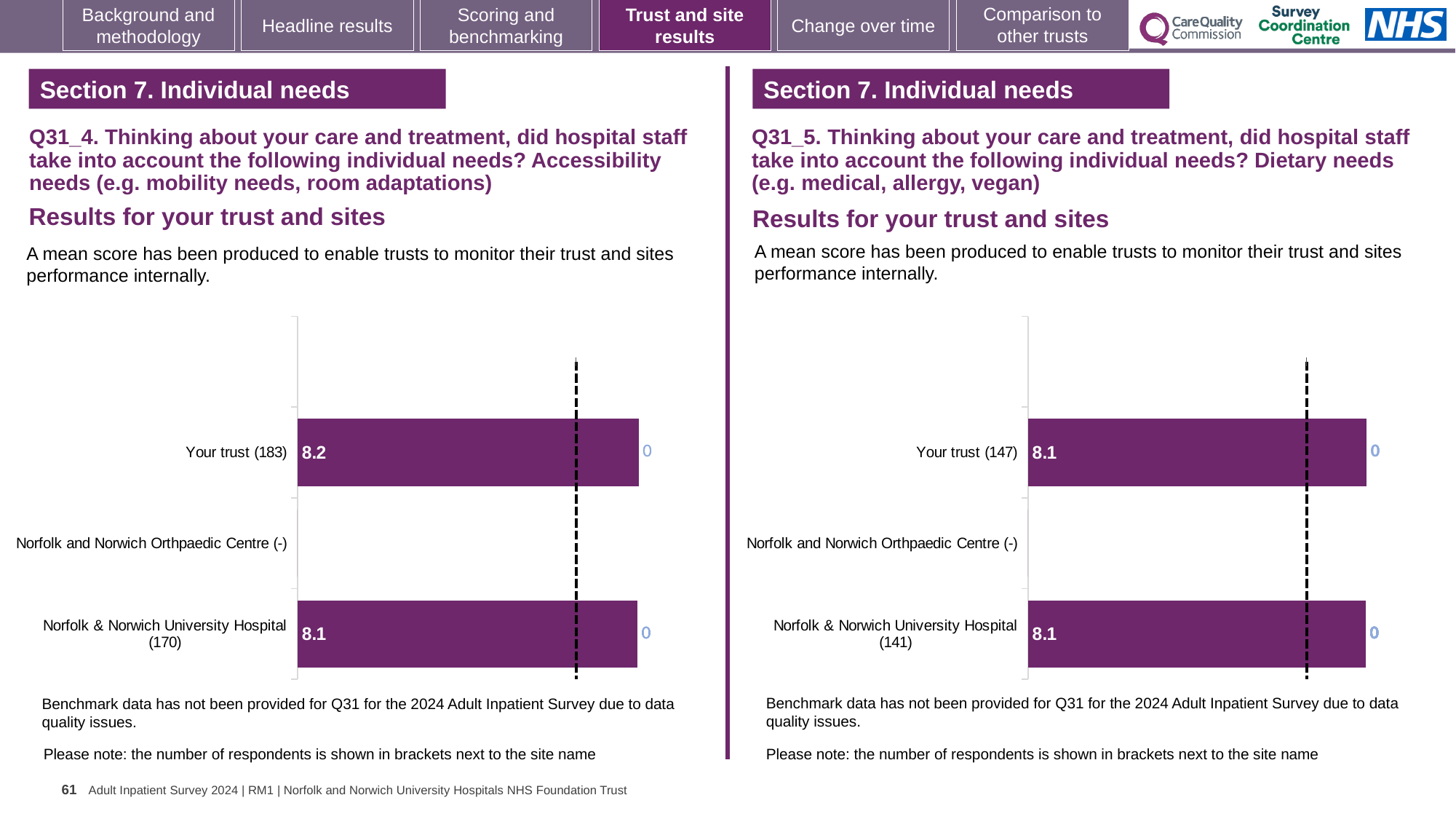
How many categories are listed on the left chart (Q31_4, Accessibility needs)? 3 On the left chart (Q31_4, Accessibility needs), what is the mean score for Your trust (183)? 8.2 On the left chart (Q31_4, Accessibility needs), how many respondents are shown in brackets for Your trust? 183 On the left chart (Q31_4, Accessibility needs), what is the mean score for Norfolk & Norwich University Hospital (170)? 8.1 What kind of chart is used on the right (Q31_5, Dietary needs)? Bar chart On the left chart (Q31_4, Accessibility needs), what is the difference between the score for Your trust (183) and Norfolk & Norwich University Hospital (170)? 0.1 On the left chart (Q31_4, Accessibility needs), which category has the highest mean score? Your trust (183) On the right chart (Q31_5, Dietary needs), what is the mean score for Norfolk & Norwich University Hospital (141)? 8.1 On the right chart (Q31_5, Dietary needs), what is the difference between the score for Your trust (147) and Norfolk & Norwich University Hospital (141)? 0 On the left chart (Q31_4, Accessibility needs), which is larger: the score for Your trust (183) or for Norfolk & Norwich University Hospital (170)? Your trust (183) On the right chart (Q31_5, Dietary needs), what is the mean score for Your trust (147)? 8.1 On the right chart (Q31_5, Dietary needs), which category has no bar plotted? Norfolk and Norwich Orthpaedic Centre (-)